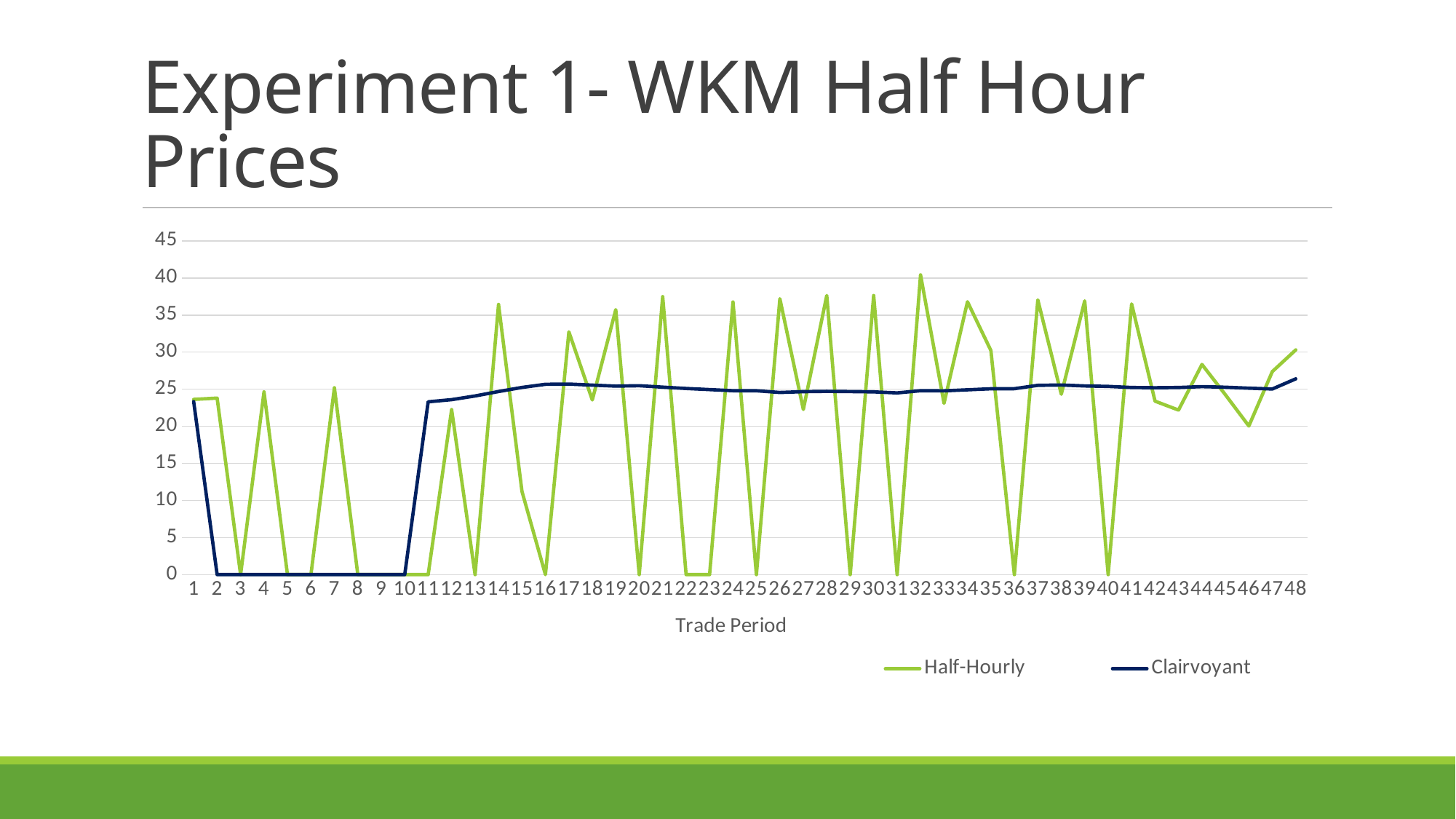
Is the Half-Hourly value at trade period 14 greater or less than 35? greater Is the Clairvoyant value at trade period 20 greater or less than 30? less How many trade periods are plotted along the x axis? 48 At which trade period does the Half-Hourly series reach its highest value? 32 How many series does the legend list? 2 What is the Half-Hourly value at trade period 3? 0 What is the Clairvoyant value at trade period 5? 0 Which series is drawn in dark blue? Clairvoyant What is the title of the x axis? Trade Period At trade period 16, which series has the larger value, Half-Hourly or Clairvoyant? Clairvoyant What kind of chart is shown on the slide? line chart Is the Clairvoyant value at trade period 1 greater or less than 20? greater